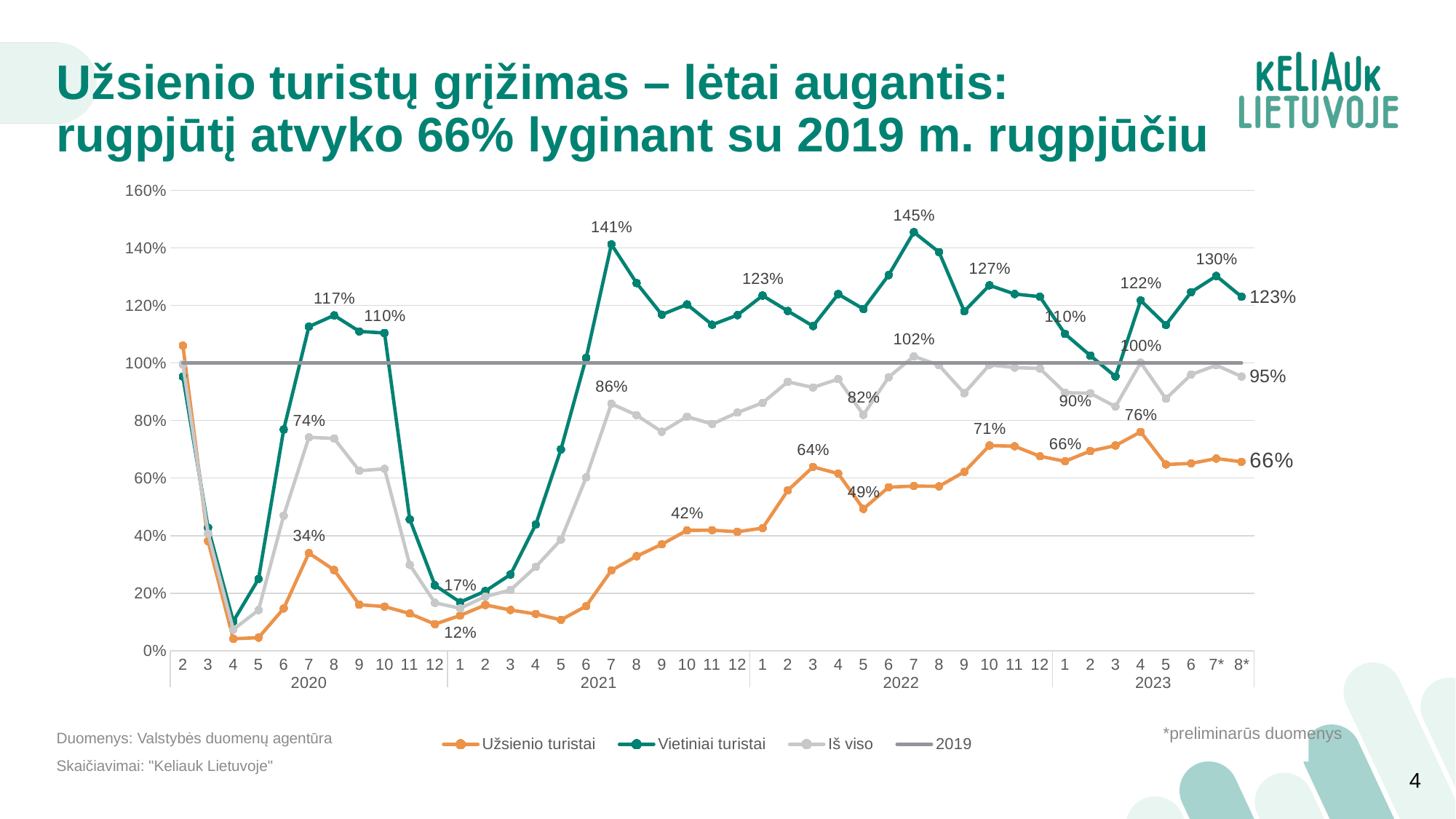
What is the difference between the Iš viso values in month 7 of 2022 and month 7 of 2021? 16 percentage points Is the value for Užsienio turistai in month 4 of 2020 greater or less than 20%? less What is the value for Užsienio turistai in month 8* of 2023? 66% What is the value for Užsienio turistai in month 4 of 2023? 76% What is the value for Vietiniai turistai in month 7 of 2021? 141% At what level is the horizontal 2019 reference line drawn? 100% What is the value for Iš viso in month 8* of 2023? 95% Which is larger for Vietiniai turistai: month 7 of 2021 or month 7 of 2022? Month 7 of 2022 What is the highest labelled value for Vietiniai turistai, and in which month does it occur? 145%, month 7 of 2022 What kind of chart is shown on the slide? Line chart How many series does the legend list? 4 What is the difference between Vietiniai turistai and Užsienio turistai in month 8* of 2023? 57 percentage points